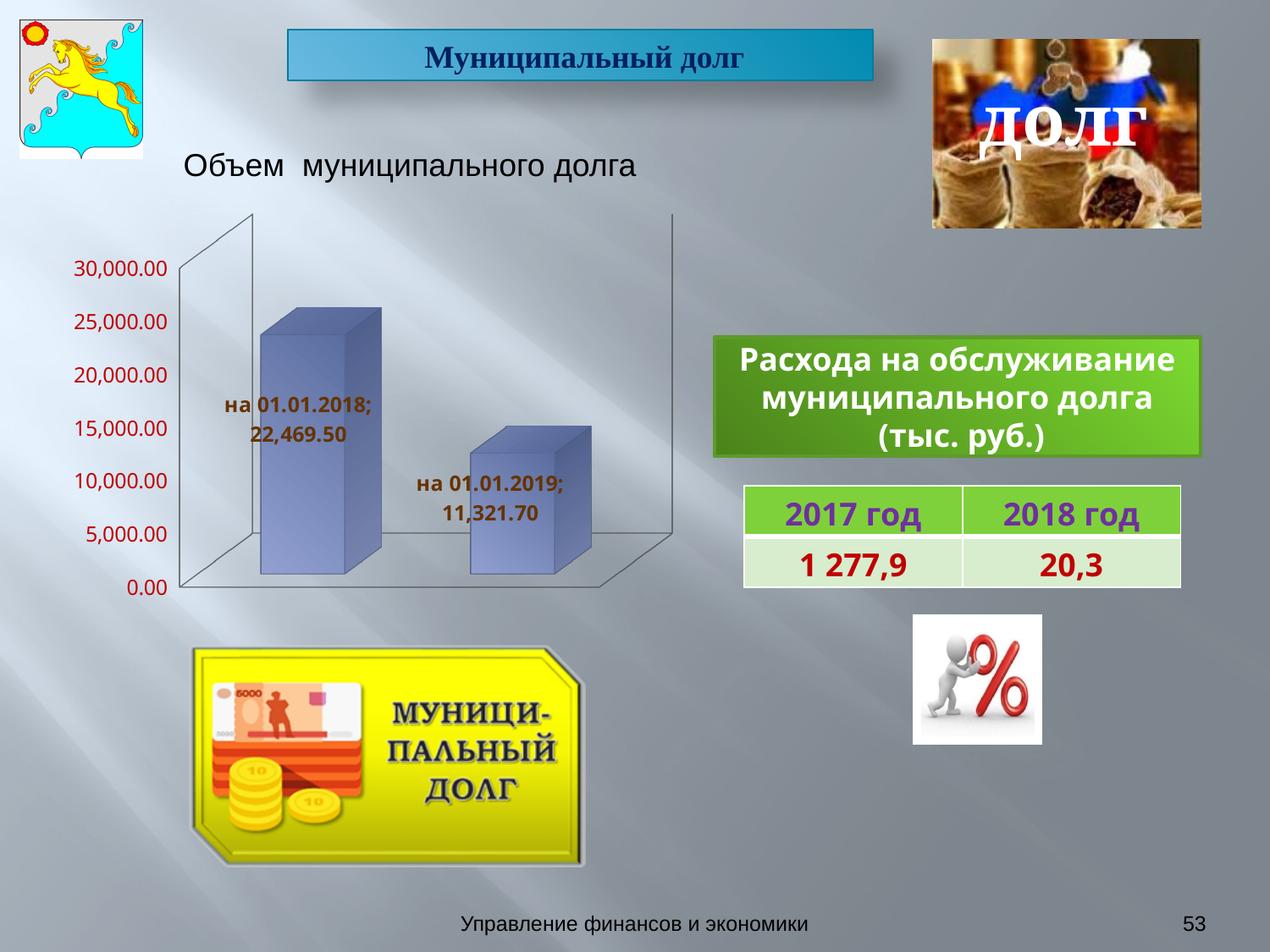
Is the municipal debt value on 01.01.2018 larger or smaller than on 01.01.2019? larger What is the value of municipal debt as of 01.01.2018 on the chart? 22,469.50 Is the value for 01.01.2019 greater or less than 15,000.00? less Which date has the higher municipal debt value on the chart? на 01.01.2018 How many bars are plotted on the chart? 2 What kind of chart is shown on the slide? bar chart Which date has the lower municipal debt value on the chart? на 01.01.2019 What is the title of the chart on the slide? Объем муниципального долга What is the difference between the municipal debt values on 01.01.2018 and 01.01.2019? 11,147.80 What is the value of municipal debt as of 01.01.2019 on the chart? 11,321.70 Do the values on the chart rise or fall from 01.01.2018 to 01.01.2019? fall Is the value for 01.01.2018 greater or less than 20,000.00? greater